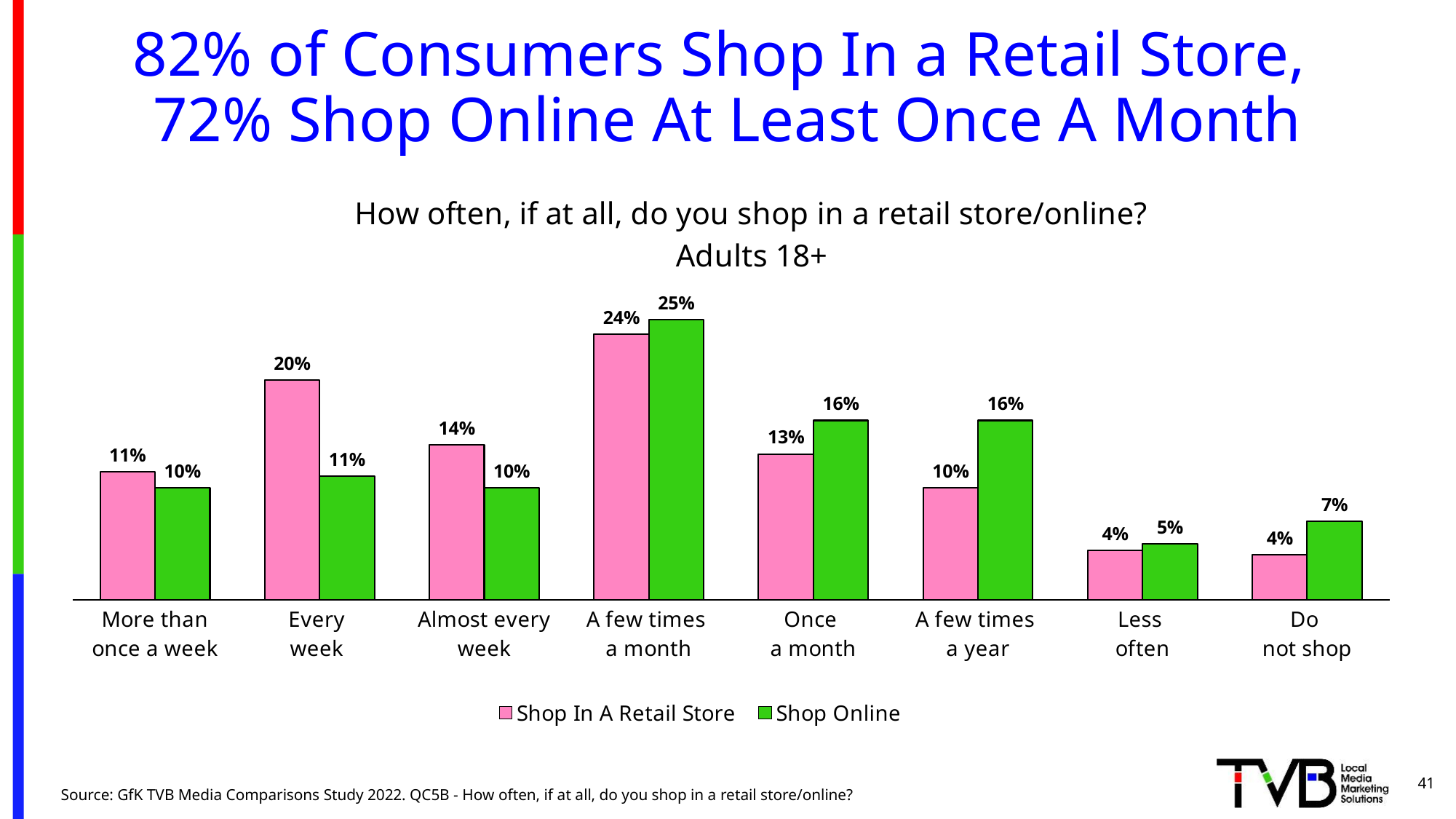
How many series does the legend list? 2 For 'Once a month', which is larger: Shop In A Retail Store or Shop Online? Shop Online How many frequency categories are shown on the x axis? 8 Which category has the highest value for Shop In A Retail Store? A few times a month Which colour represents the Shop Online series? Green What percentage of adults shop online a few times a month? 25% What is the difference between Shop In A Retail Store and Shop Online for 'Every week'? 9 percentage points What percentage of adults shop in a retail store every week? 20% Which category has the lowest value for Shop Online? Less often What kind of chart is shown on the slide? Bar chart What is the difference between Shop Online and Shop In A Retail Store for 'A few times a year'? 6 percentage points What is the value for Shop Online in the 'Do not shop' category? 7%